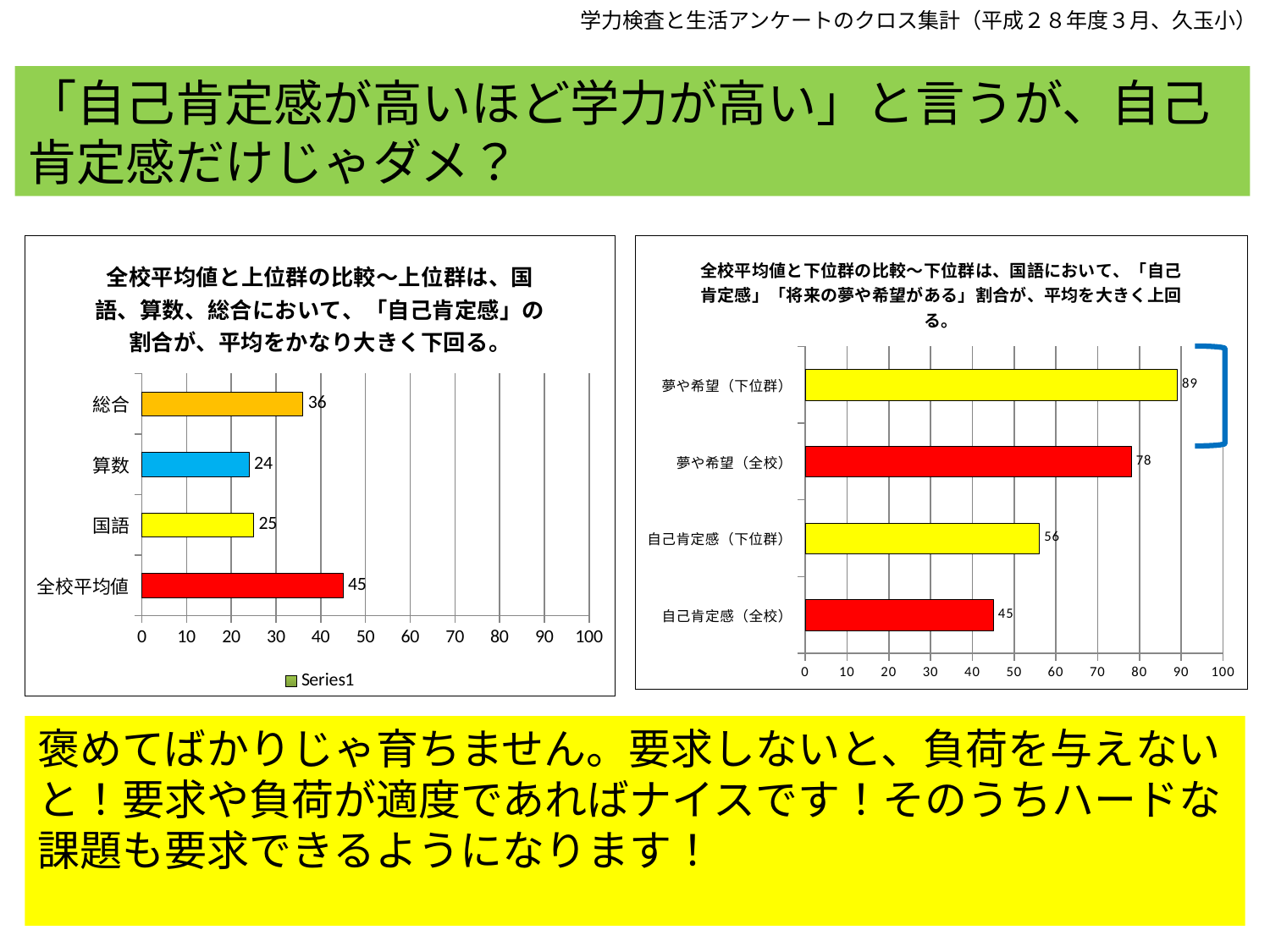
In the left chart, what is the value for 全校平均値? 45 In the left chart, what is the difference between 全校平均値 and 国語? 20 In the right chart, which category has the highest value? 夢や希望（下位群） What type of chart is the right chart? bar chart In the left chart, what is the value for 総合? 36 In the right chart, what is the value for 自己肯定感（下位群）? 56 In the left chart, how many categories are plotted? 4 In the left chart, which category has the lowest value? 算数 In the left chart, what is the legend entry shown? Series1 In the right chart, what is the value for 夢や希望（下位群）? 89 In the right chart, which is larger: 自己肯定感（下位群） or 自己肯定感（全校）? 自己肯定感（下位群） In the right chart, what is the difference between 夢や希望（下位群） and 夢や希望（全校）? 11